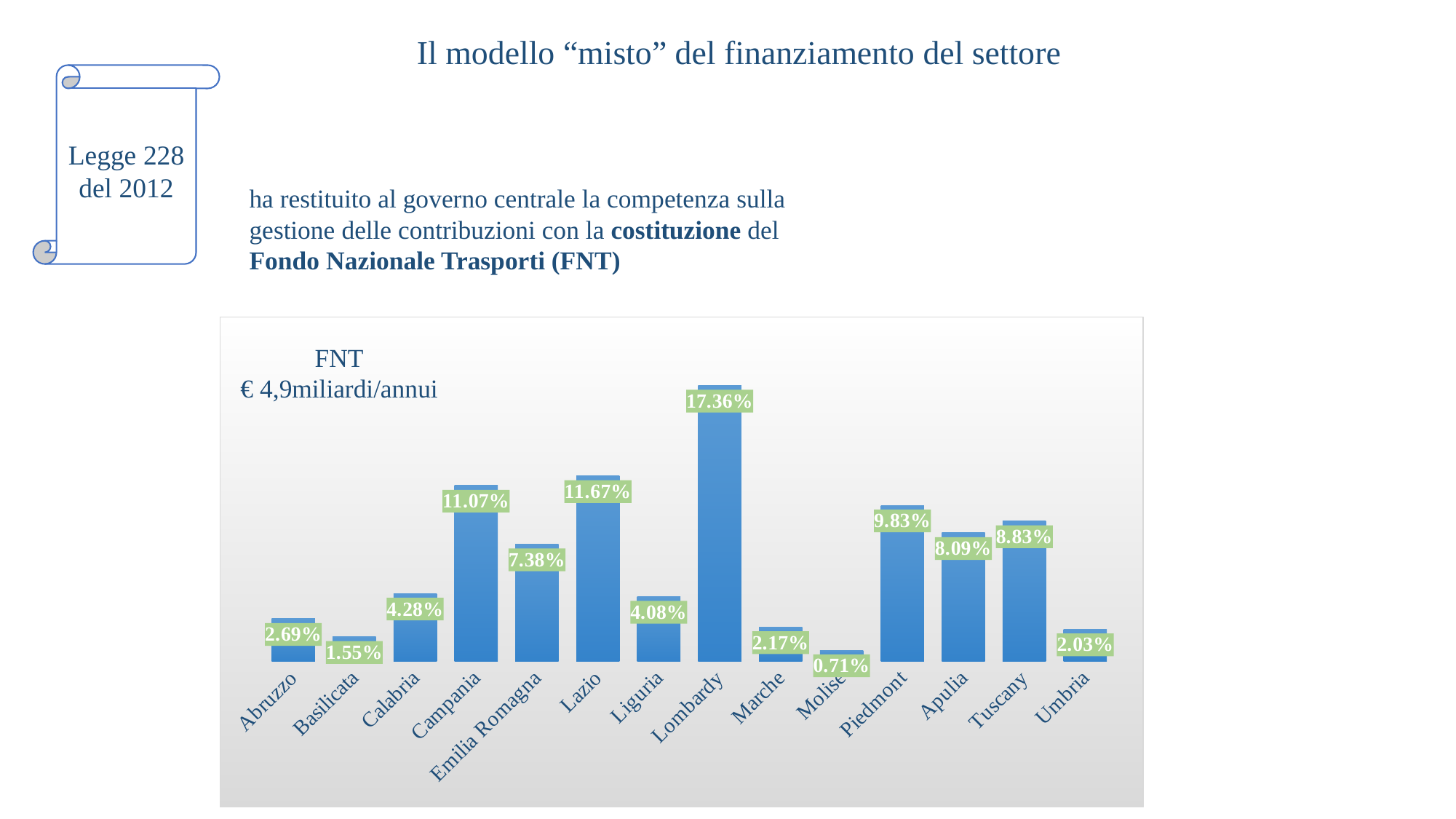
What is the difference between the values for Lazio and Campania? 0.60% What is the difference between the values for Lombardy and Piedmont? 7.53% How many regions are shown in the chart? 14 What is the value shown for Emilia Romagna? 7.38% Which has a larger value, Tuscany or Apulia? Tuscany Which region has the highest value? Lombardy What kind of chart is shown on the slide? Bar chart Which region has the lowest value? Molise What annual amount is stated in the chart's title text for the FNT? € 4,9miliardi/annui Which has a larger value, Abruzzo or Marche? Abruzzo What is the value shown for Lombardy? 17.36% What is the value shown for Piedmont? 9.83%